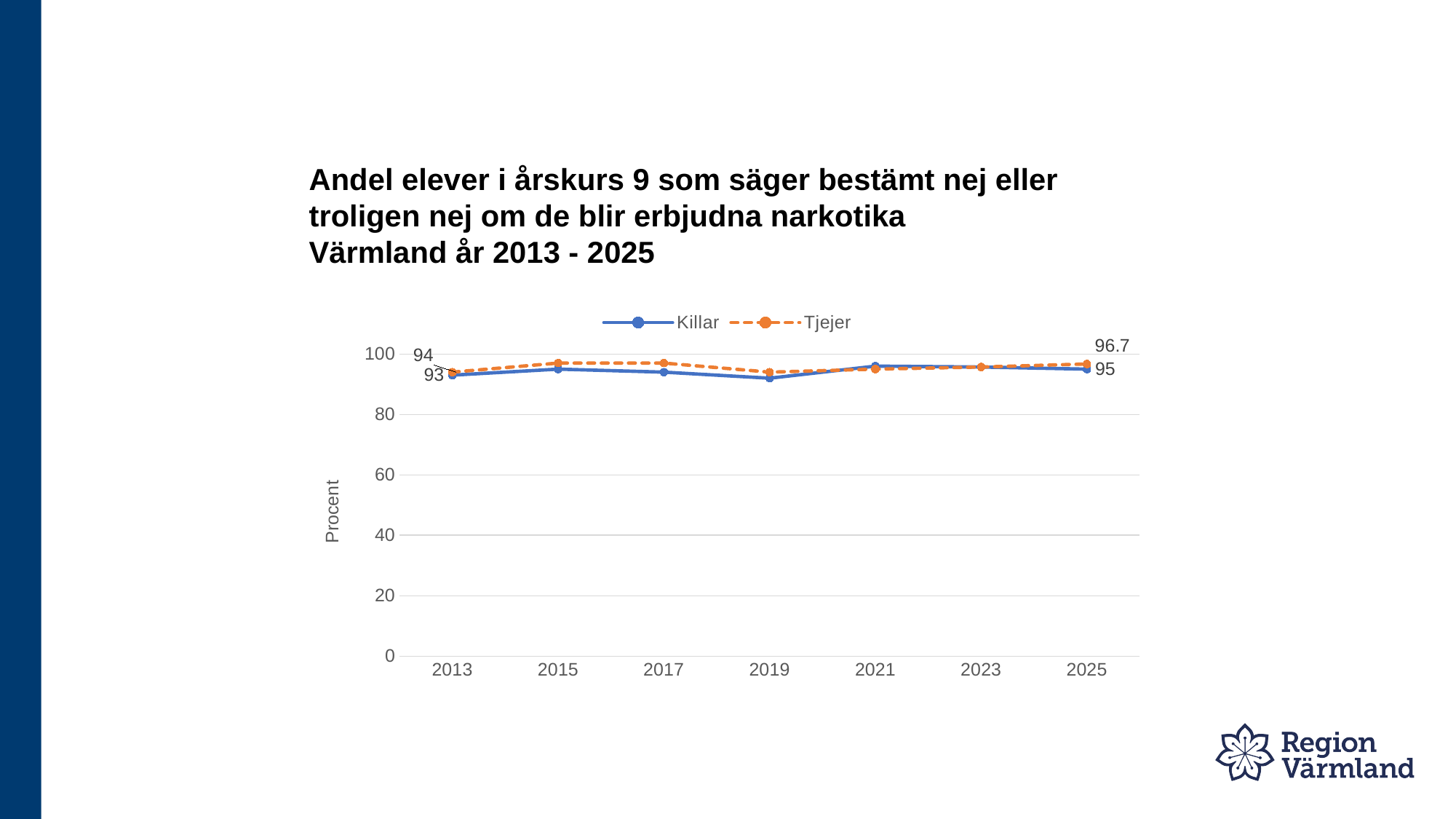
What is the value for Tjejer in 2025? 96.7 Is the value for Killar in 2019 greater or less than 80? greater What is the difference between the Tjejer and Killar values in 2025? 1.7 What is the value for Killar in 2025? 95 What is the value for Tjejer in 2013? 94 What kind of chart is shown on the slide? Line chart Which series has the higher value in 2013, Killar or Tjejer? Tjejer What is the difference between the Tjejer and Killar values in 2013? 1 How many series does the legend list? 2 In which year is the Killar value lowest? 2019 How many years are shown on the x axis? 7 What is the value for Killar in 2013? 93